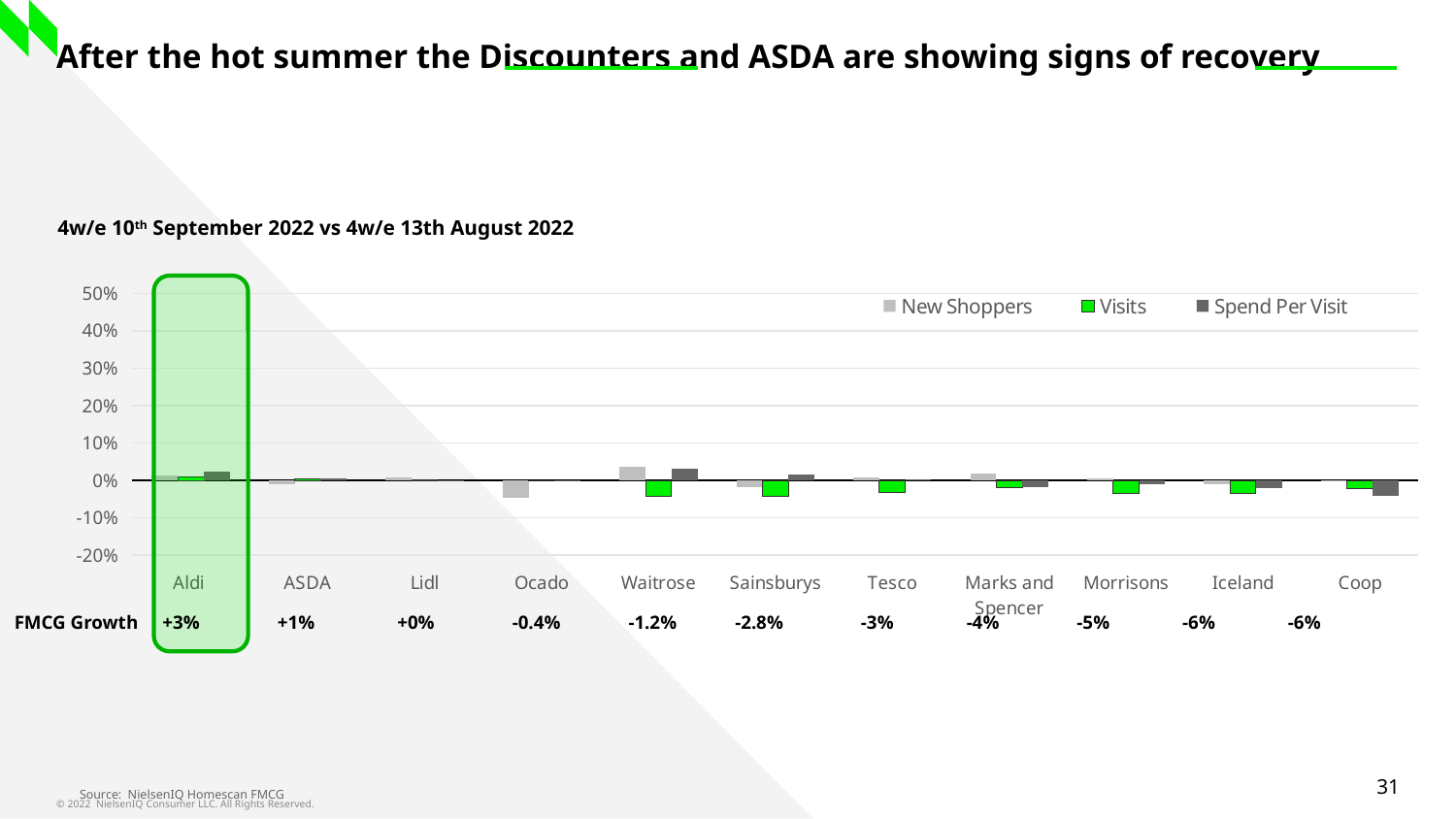
What is the title printed above the chart? 4w/e 10th September 2022 vs 4w/e 13th August 2022 Is the New Shoppers value for Waitrose greater or less than 0%? greater Is the Visits value for Waitrose greater or less than 0%? less Which retailer is highlighted with a green box on the chart? Aldi How many series does the chart legend list? 3 Is the Visits value for Aldi greater or less than 10%? less What is the FMCG Growth figure shown for Aldi? +3% Which retailer has the highest FMCG Growth figure shown below the chart? Aldi What kind of chart is shown on the slide? bar chart Which has the larger FMCG Growth figure, ASDA or Lidl? ASDA What is the FMCG Growth figure shown for Tesco? -3% How many retailers are shown along the x axis of the chart? 11